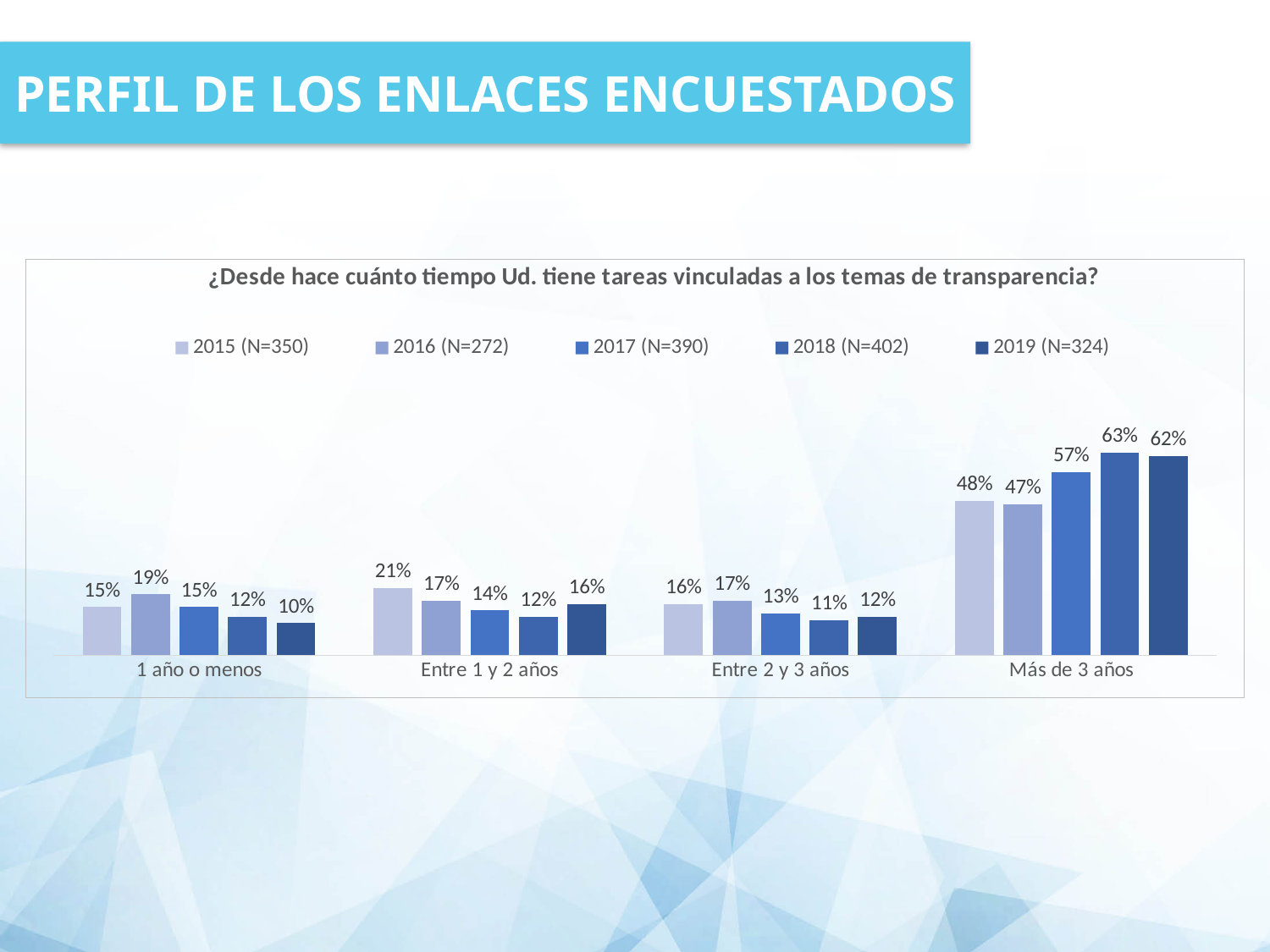
Which year has the highest value in the 'Más de 3 años' category? 2018 (N=402) What is the value for 2018 (N=402) in the '1 año o menos' category? 12% What type of chart is shown on the slide? Bar chart What is the value for 2019 (N=324) in the 'Más de 3 años' category? 62% What is the difference between the 2018 (N=402) and 2015 (N=350) values in the 'Más de 3 años' category? 15% What is the value for 2015 (N=350) in the 'Entre 1 y 2 años' category? 21% In the 'Entre 2 y 3 años' category, which is larger: the value for 2016 (N=272) or the value for 2018 (N=402)? 2016 (N=272) How many series does the legend list? 5 What is the title of the chart? ¿Desde hace cuánto tiempo Ud. tiene tareas vinculadas a los temas de transparencia? Which year has the lowest value in the '1 año o menos' category? 2019 (N=324) Which category has the highest values across all years? Más de 3 años How many categories are shown on the x axis? 4